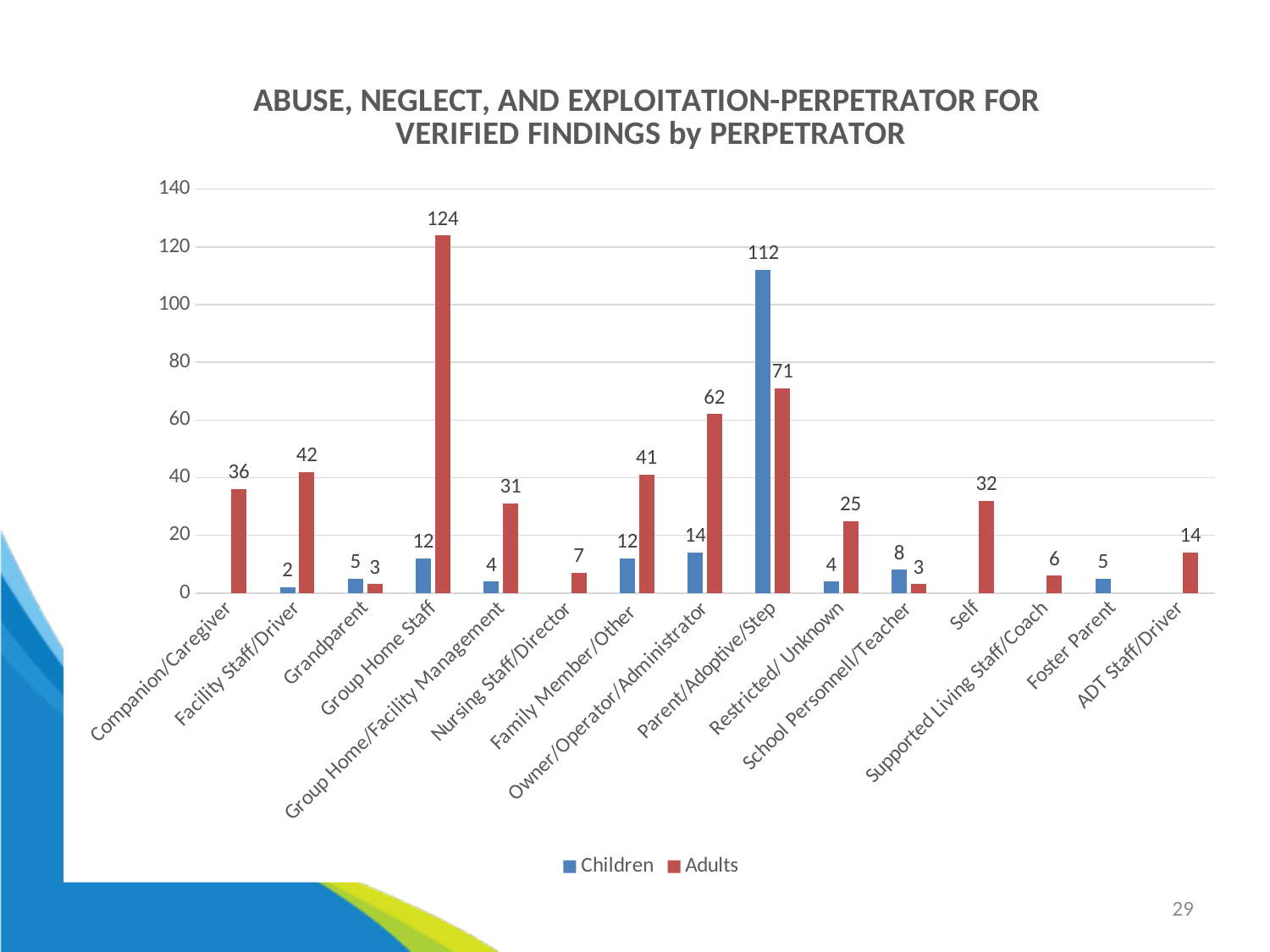
How many categories are shown on the x axis? 15 What is the Adults value for Owner/Operator/Administrator? 62 How many series does the legend list? 2 What is the difference between the Children and Adults values for Parent/Adoptive/Step? 41 Which category has the highest Children value? Parent/Adoptive/Step Which category has the highest Adults value? Group Home Staff What is the Adults value for Group Home Staff? 124 What is the Children value for Parent/Adoptive/Step? 112 Is the Adults value for Facility Staff/Driver greater or less than 40? greater Which is larger for Grandparent, the Children value or the Adults value? Children What kind of chart is shown on the slide? Bar chart Which colour represents the Adults series? Red